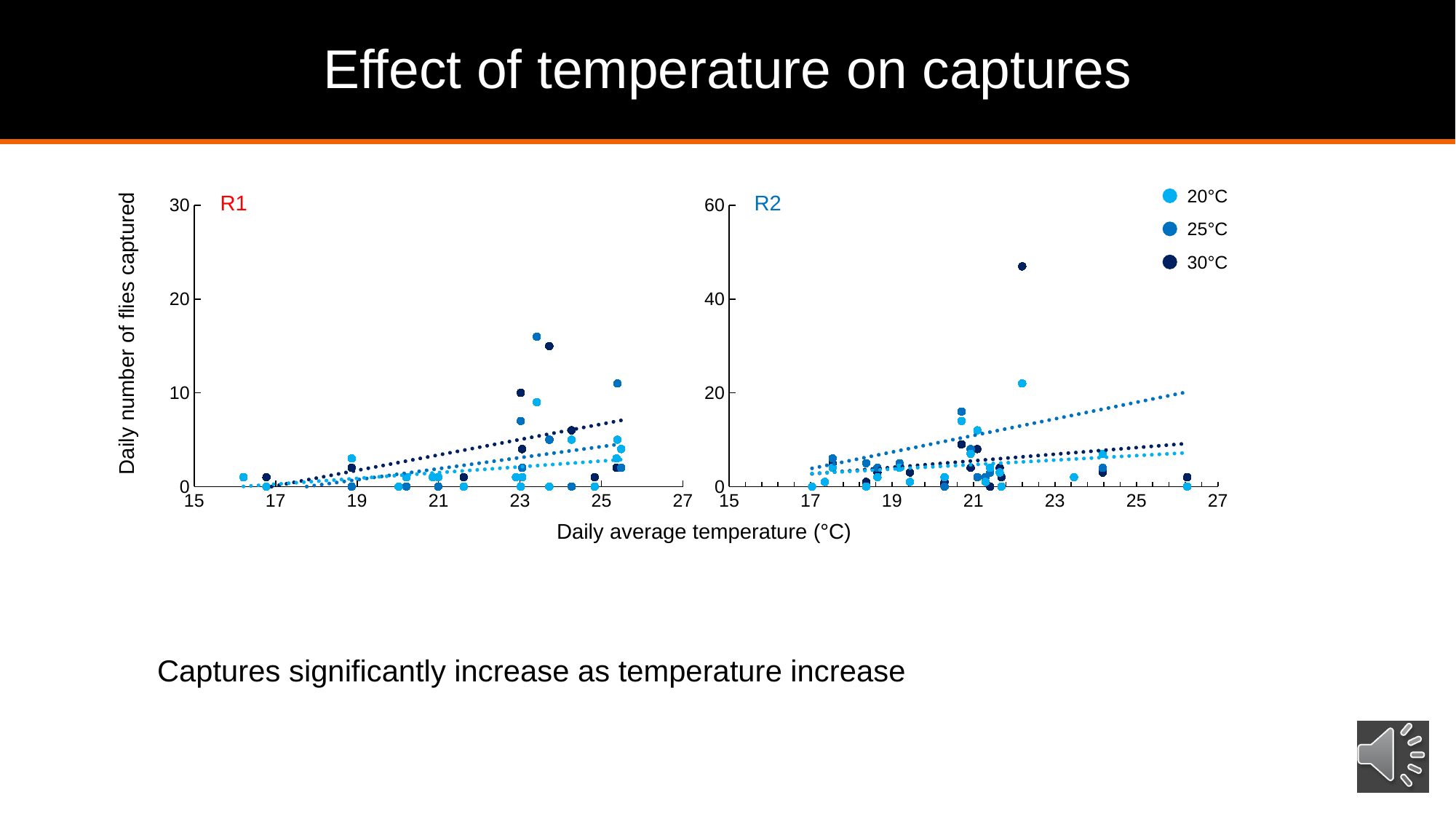
What is the title of the x axis shared by the two charts? Daily average temperature (°C) How many series does the legend list? 3 Which chart, R1 or R2, has the higher maximum value on its y axis? R2 What are the three series named in the legend? 20°C, 25°C, 30°C In the R2 chart, which series does the highest plotted point belong to? 30°C What kind of chart is used in the R1 and R2 panels? scatter chart In the R1 chart, is the highest plotted point greater or less than 20 flies captured? less In the R1 chart, do the dotted trend lines rise or fall as daily average temperature increases? rise In the R2 chart, is the highest plotted point greater or less than 40 flies captured? greater In the R1 chart, is the highest plotted point greater or less than 10 flies captured? greater In the R2 chart, do the dotted trend lines rise or fall as daily average temperature increases? rise